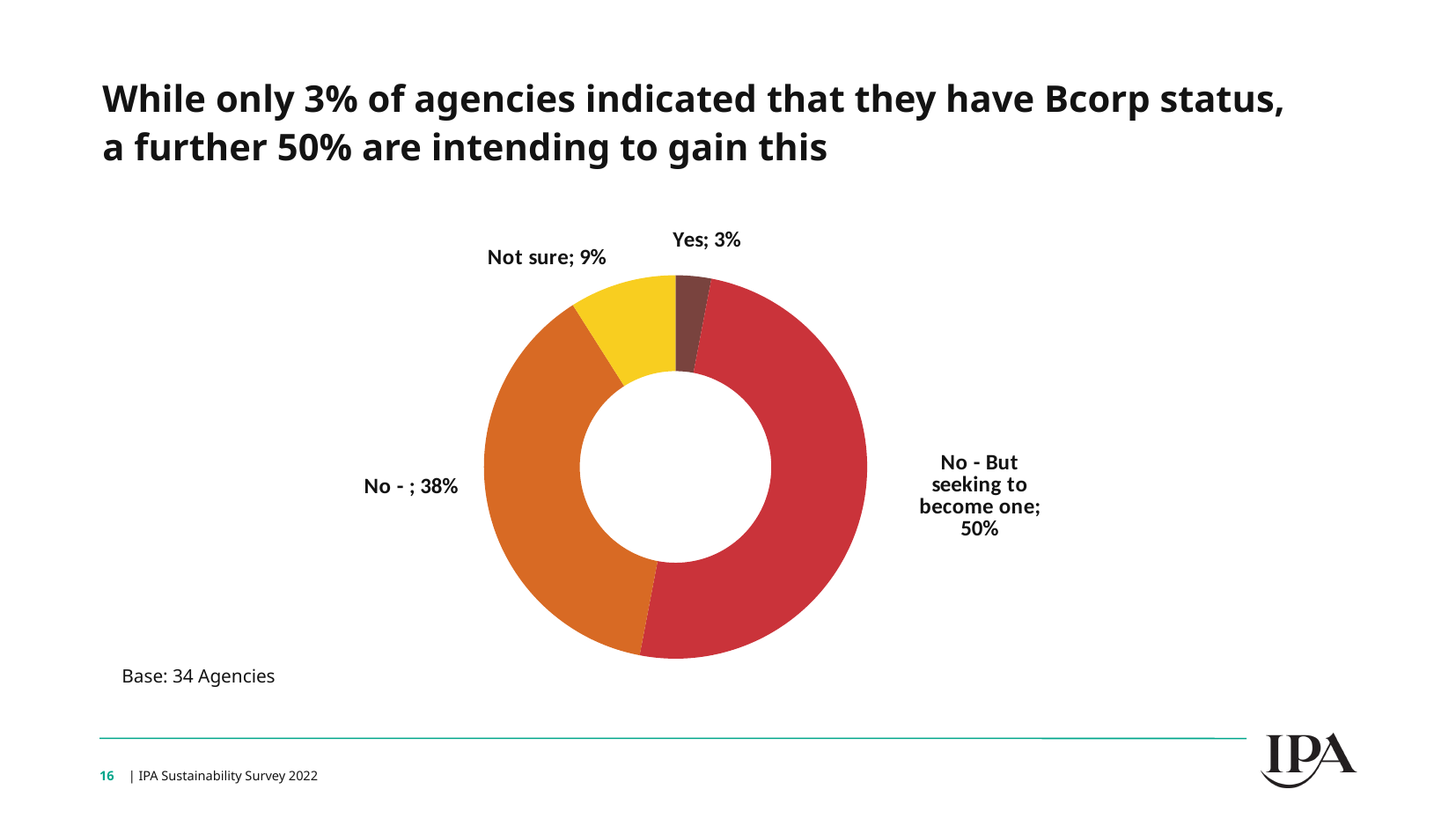
Which is larger, the share for 'Not sure' or the share for 'Yes'? Not sure Which response category has the smallest share of the pie? Yes Which response category has the largest share of the pie? No - But seeking to become one What percentage of agencies answered 'No -'? 38% How many response categories are shown in the chart? 4 What is the difference in percentage points between 'No - But seeking to become one' and 'No -'? 12 What is the base (number of agencies) stated for the chart? 34 Agencies What kind of chart is shown on the slide? Pie chart (doughnut) What colour is the 'Not sure' slice? Yellow What percentage of agencies answered 'Yes' to having Bcorp status? 3% What percentage of agencies answered 'Not sure'? 9% What share of agencies answered 'No - But seeking to become one'? 50%